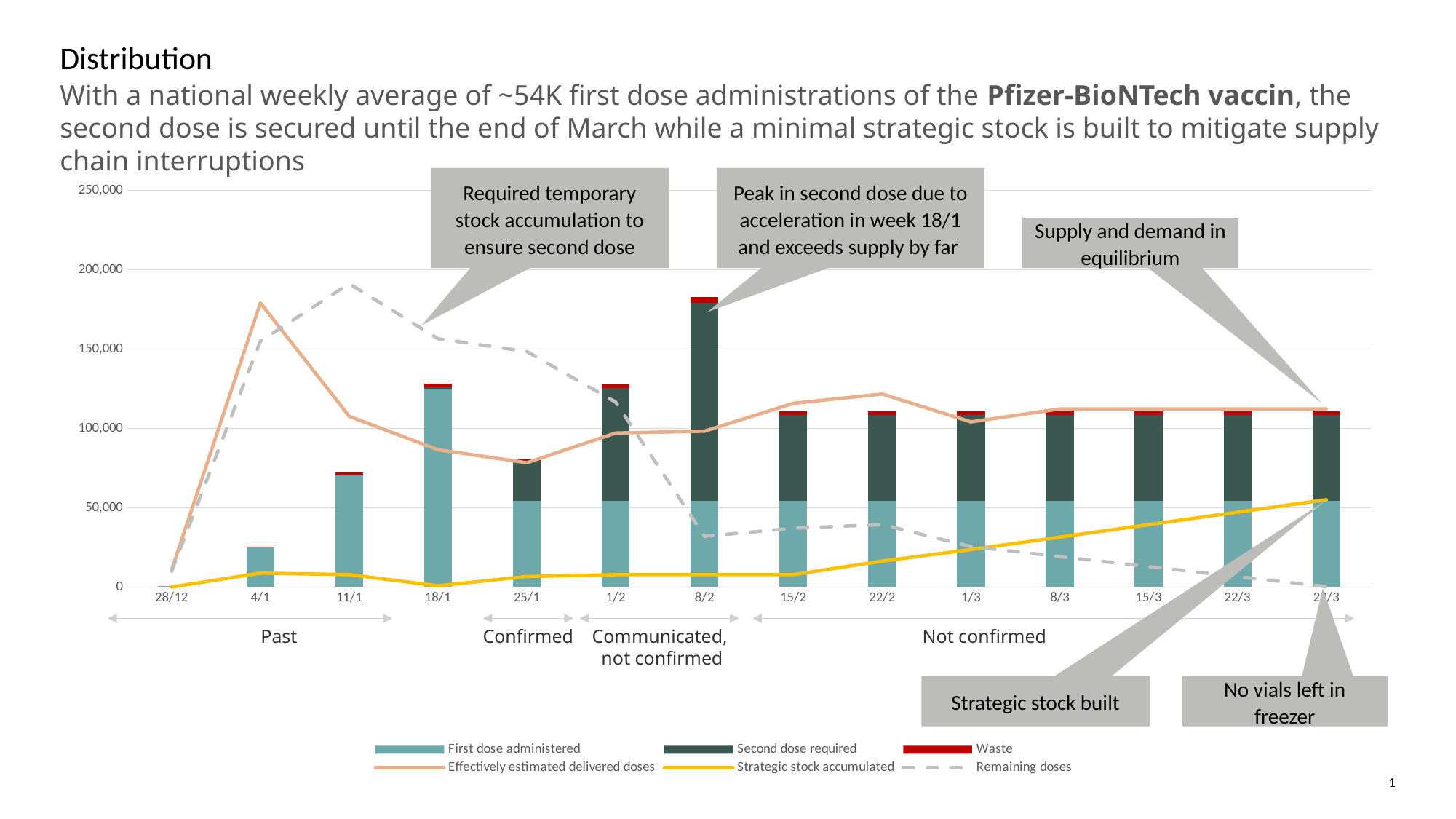
Which legend series is shown in red? Waste Is the 'Effectively estimated delivered doses' value at 4/1 greater or less than 150,000? greater Which stacked bar is taller, 11/1 or 4/1? 11/1 What kind of chart is shown on the slide? A combination chart of stacked bars and lines How many series does the legend list? 6 Is the stacked bar for 4/1 greater or less than 50,000? less How many weeks (categories) are shown on the x axis? 14 Which series is drawn as a grey dashed line? Remaining doses Is the total stacked bar for 8/2 greater or less than 150,000? greater Does the 'Strategic stock accumulated' line rise or fall from 15/2 to 29/3? rise Which week has the tallest stacked bar? 8/2